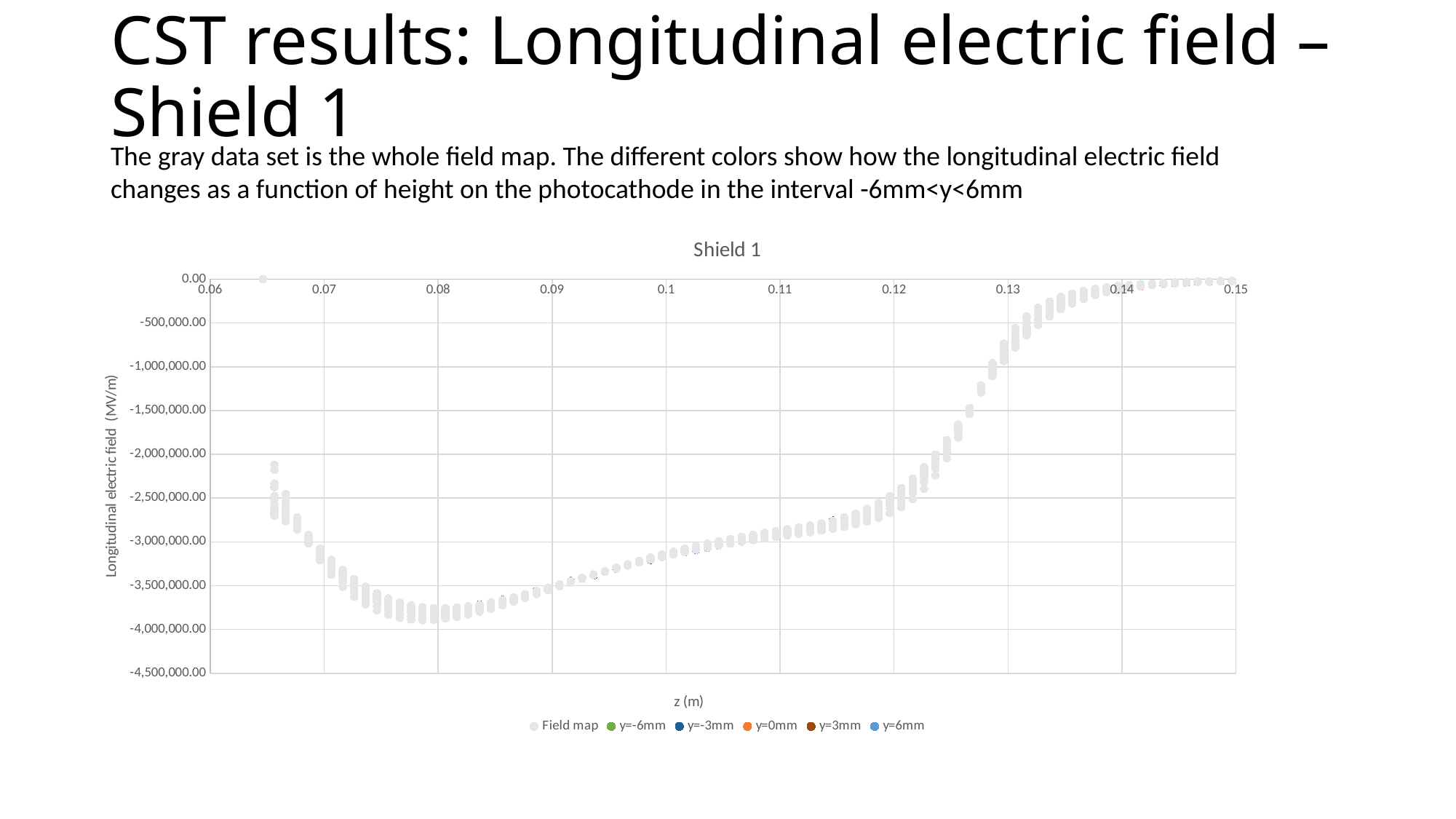
What kind of chart is shown on the slide? Scatter chart In the Shield 1 chart, do the Field map values rise or fall as z increases from 0.065 to 0.08? fall In the Shield 1 chart, is the Field map value at z = 0.1 greater or less than -3,500,000.00? greater In the Shield 1 chart, is the Field map value at z = 0.12 greater or less than -3,000,000.00? greater How many series does the legend of the Shield 1 chart list? 6 In the Shield 1 chart, do the Field map values rise or fall as z increases from 0.08 to 0.15? rise In the Shield 1 chart, is the Field map value at z = 0.08 greater or less than -3,500,000.00? less What is the label of the x axis of the Shield 1 chart? z (m) What is the title of the chart on the slide? Shield 1